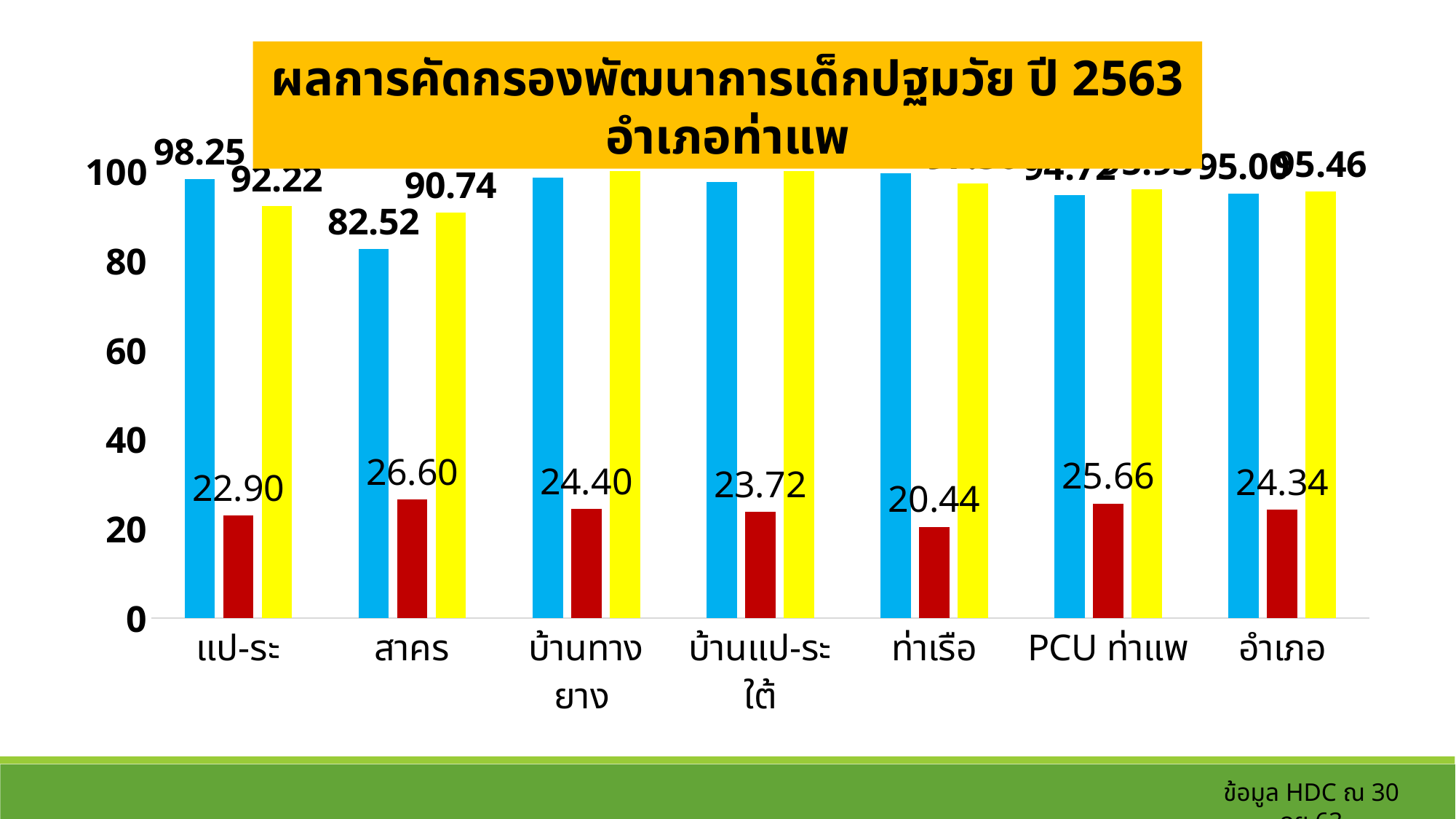
What is the difference between the blue bar and the yellow bar for แป-ระ? 6.03 Which category has the highest red bar? สาคร How many categories are shown along the x axis of the chart? 7 What is the value of the blue bar for สาคร? 82.52 What kind of chart is shown on the slide? bar chart Which category has the lowest red bar? ท่าเรือ What is the value of the yellow bar for แป-ระ? 92.22 What is the value of the red bar for แป-ระ? 22.90 What is the value of the red bar for ท่าเรือ? 20.44 How many bars are plotted for each category in the chart? 3 Which category has the lowest blue bar? สาคร What is the value of the red bar for PCU ท่าแพ? 25.66